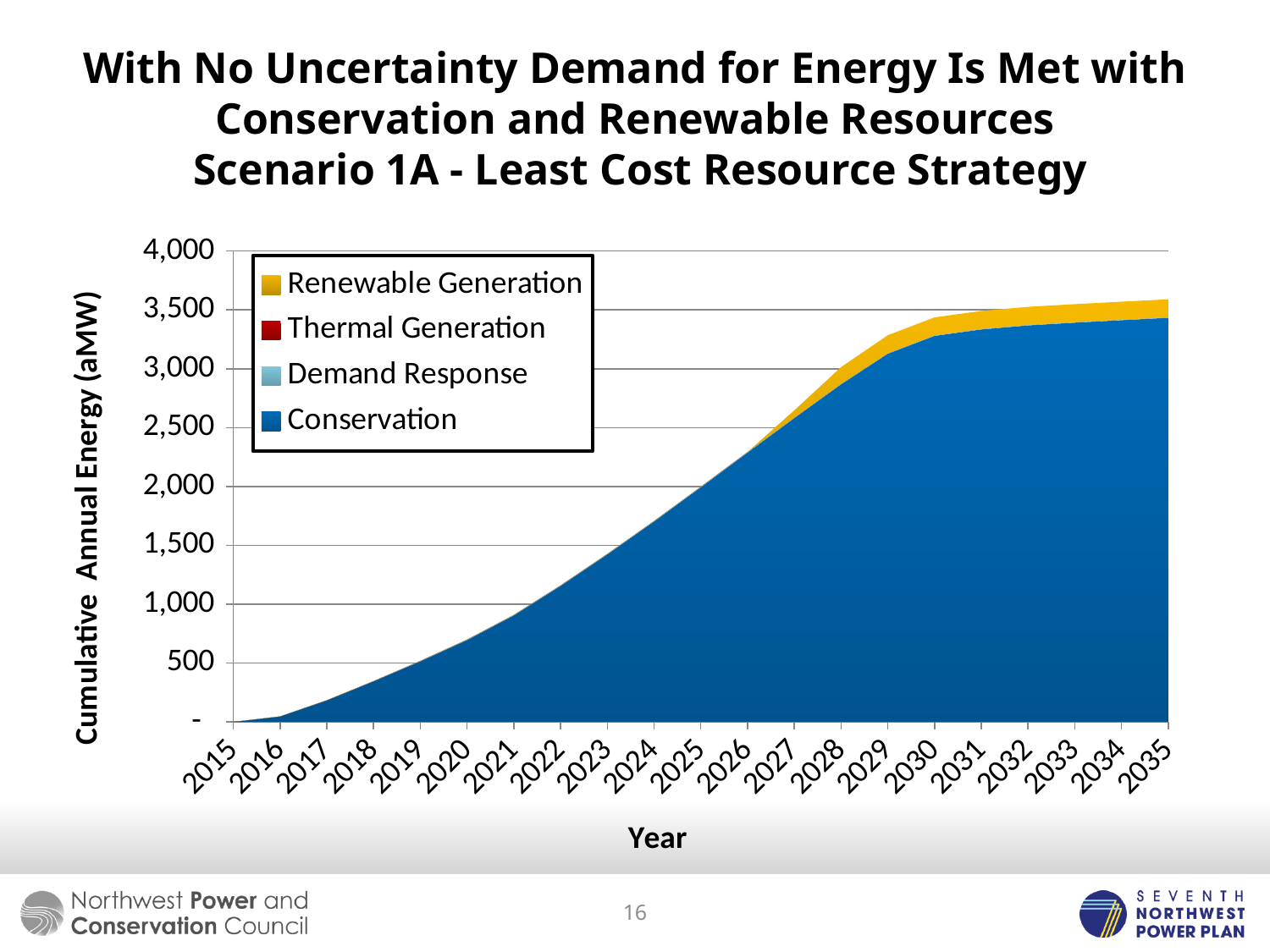
Which series is the largest contributor to the stacked total in 2035, Conservation or Renewable Generation? Conservation In which year is the total cumulative annual energy highest? 2035 What is the label of the y axis? Cumulative Annual Energy (aMW) Is the Conservation value in 2020 greater or less than 500? greater What kind of chart is shown on the slide? Stacked area chart Is the Conservation value in 2023 greater or less than 1,500? less How many years are shown along the x axis? 21 Does the cumulative annual energy rise or fall from 2015 to 2035? Rises Is the Conservation value in 2018 greater or less than 500? less How many series does the legend list? 4 In which year is the total cumulative annual energy lowest? 2015